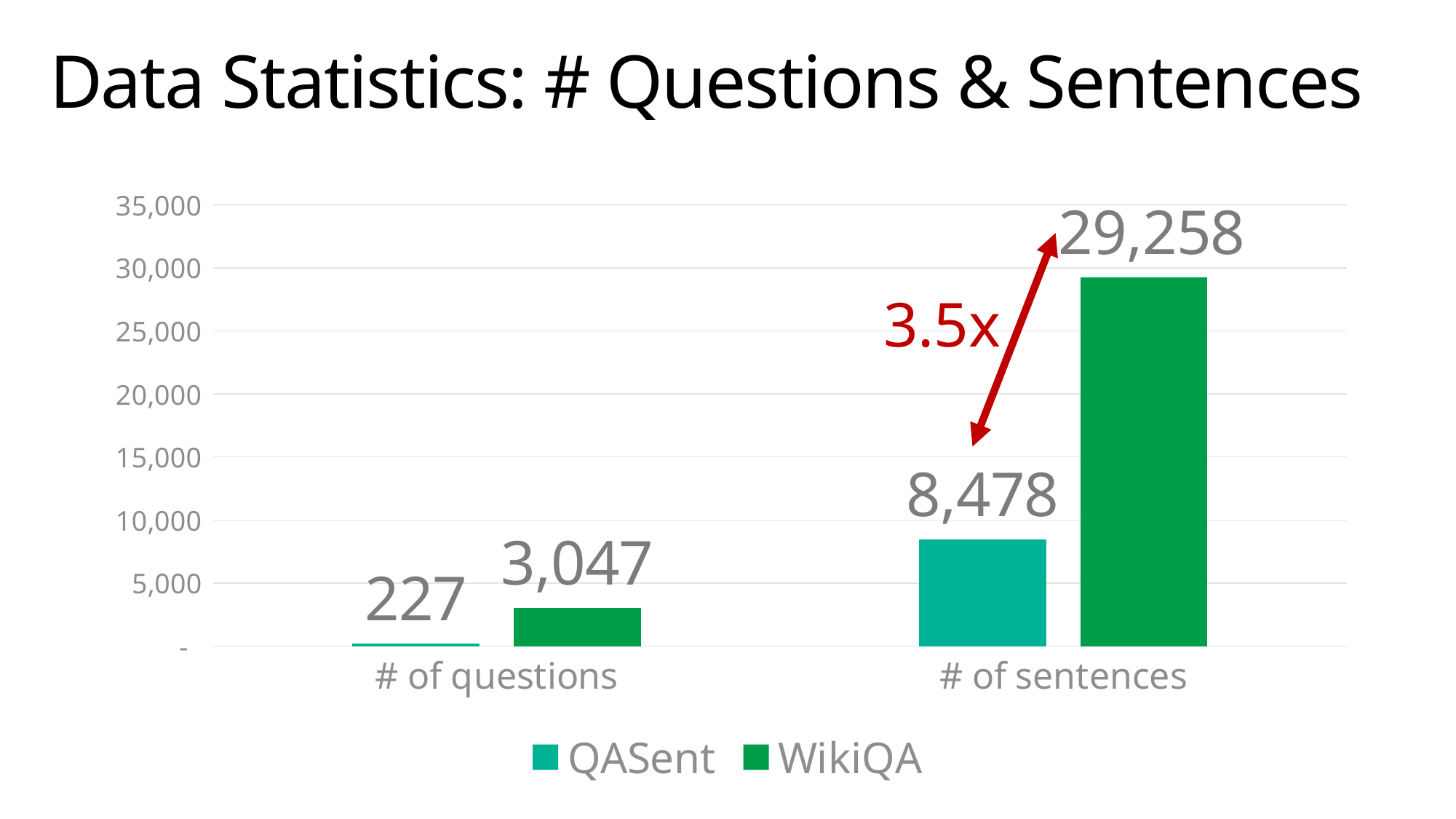
Which series has the highest value for # of sentences? WikiQA What is the number of sentences for WikiQA? 29,258 What is the number of sentences for QASent? 8,478 What is the number of questions for WikiQA? 3,047 What is the difference between the WikiQA and QASent values for # of questions? 2,820 What is the difference between the WikiQA and QASent values for # of sentences? 20,780 What ratio is annotated in red between the two # of sentences bars? 3.5x How many series does the legend list? 2 Which is larger: the QASent number of sentences or the WikiQA number of questions? QASent number of sentences What is the number of questions for QASent? 227 What kind of chart is shown on the slide? Bar chart Which bar has the lowest value on the chart? QASent, # of questions